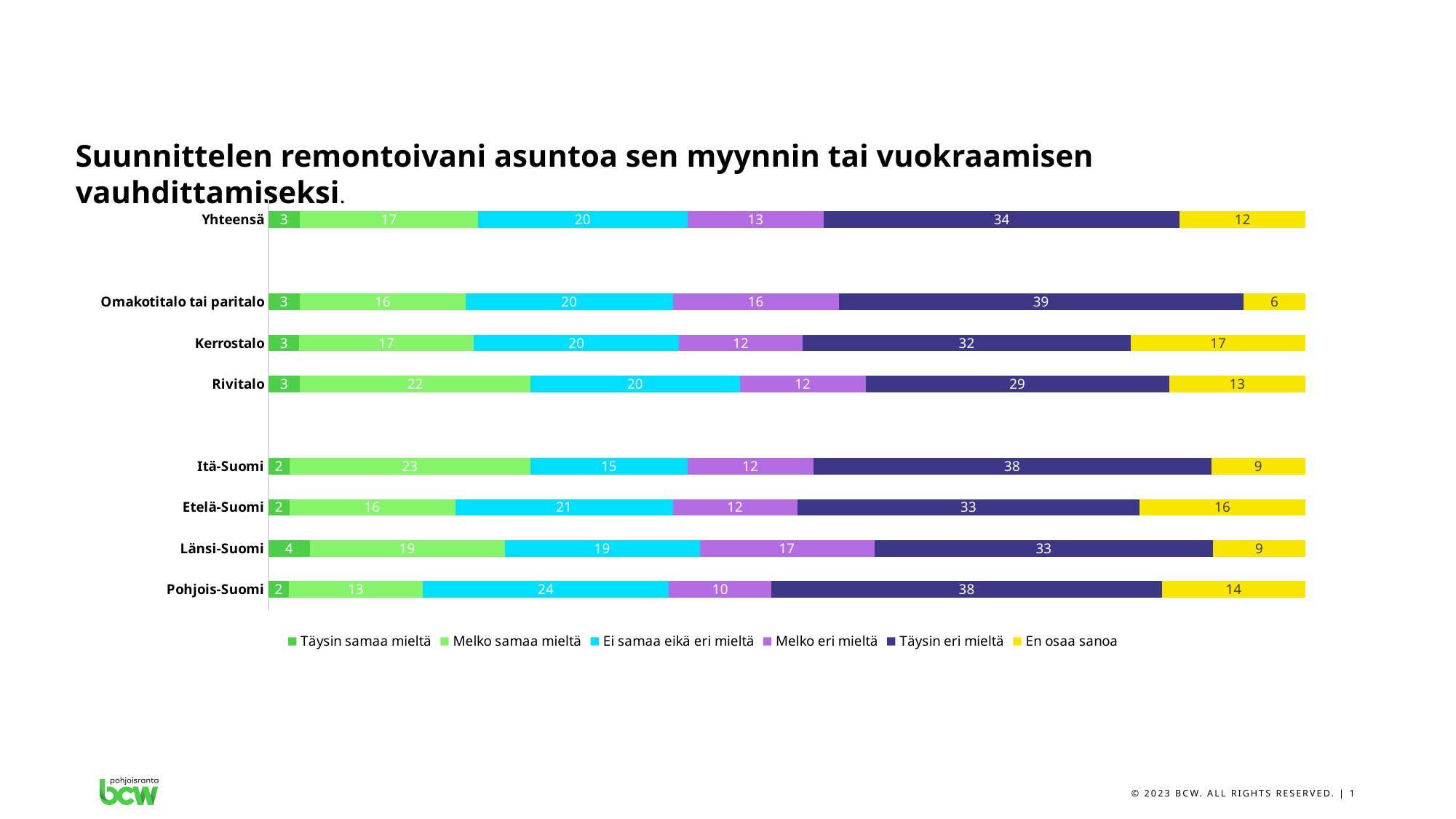
What is the total of the stacked bar for Omakotitalo tai paritalo? 100 What is the difference between the 'Täysin eri mieltä' values for Itä-Suomi and Rivitalo? 9 What is the value of 'Melko samaa mieltä' for Rivitalo? 22 What is the value of 'En osaa sanoa' for Kerrostalo? 17 How many series does the legend list? 6 What is the value of 'Täysin eri mieltä' for Yhteensä? 34 What kind of chart is shown on the slide? Stacked bar chart How many categories (bars) are shown in the chart? 8 Which category has the lowest value for 'En osaa sanoa'? Omakotitalo tai paritalo What is the value of 'Ei samaa eikä eri mieltä' for Pohjois-Suomi? 24 Which is larger: the 'Melko eri mieltä' value for Länsi-Suomi or for Etelä-Suomi? Länsi-Suomi Which category has the highest value for 'Täysin eri mieltä'? Omakotitalo tai paritalo